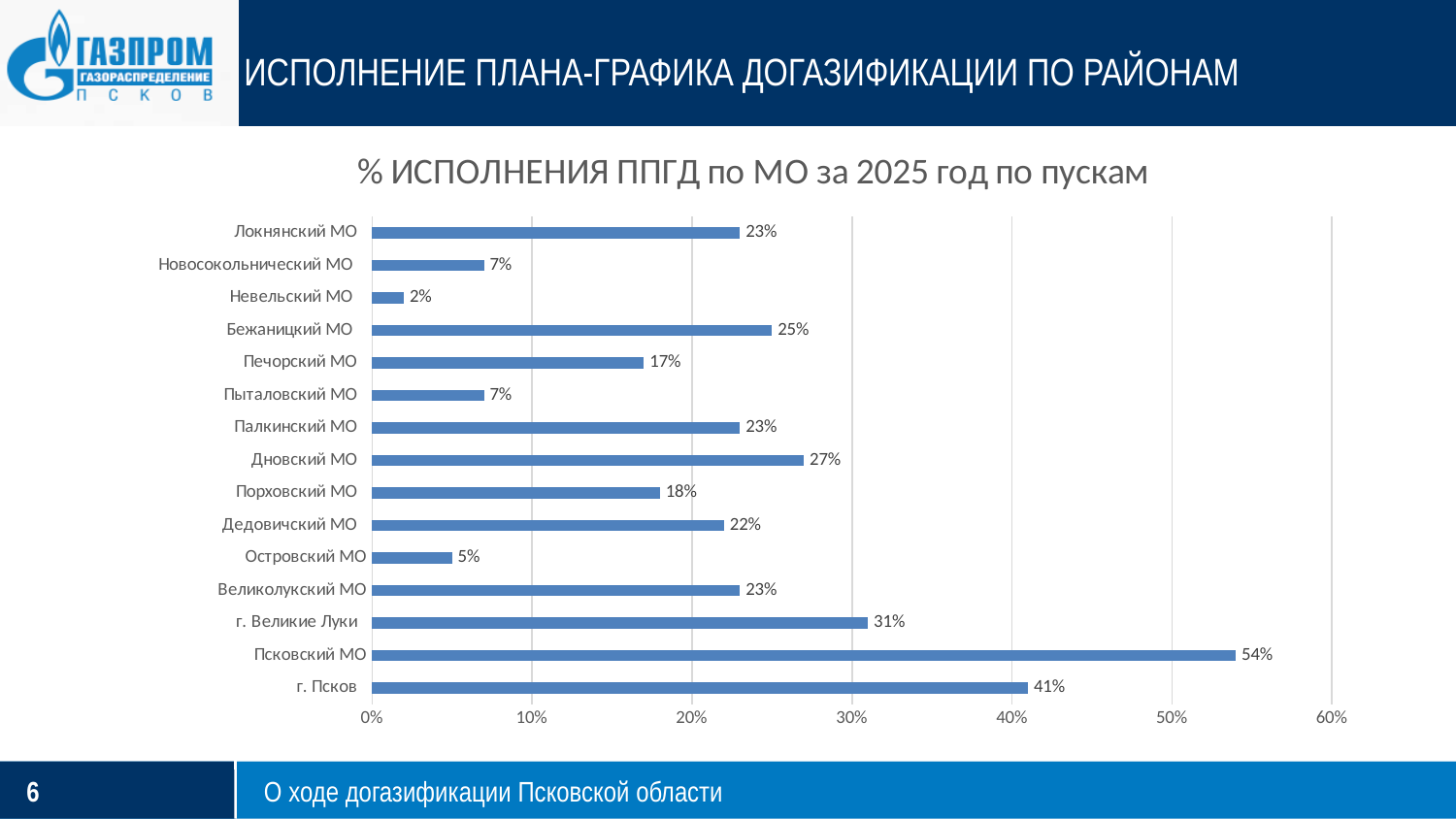
Which category has the highest value? Псковский МО What is the difference between the values for Псковский МО and г. Псков? 13% How many categories are shown on the chart? 15 Which is larger, the value for Дновский МО or the value for Бежаницкий МО? Дновский МО What is the value for Печорский МО? 17% Which category has the lowest value? Невельский МО What kind of chart is shown on the slide? Bar chart What is the difference between the values for Дедовичский МО and Островский МО? 17% What is the value for Псковский МО? 54% Is the value for г. Псков greater or less than 40%? greater What is the title of the chart? % ИСПОЛНЕНИЯ ППГД по МО за 2025 год по пускам What is the value for г. Великие Луки? 31%